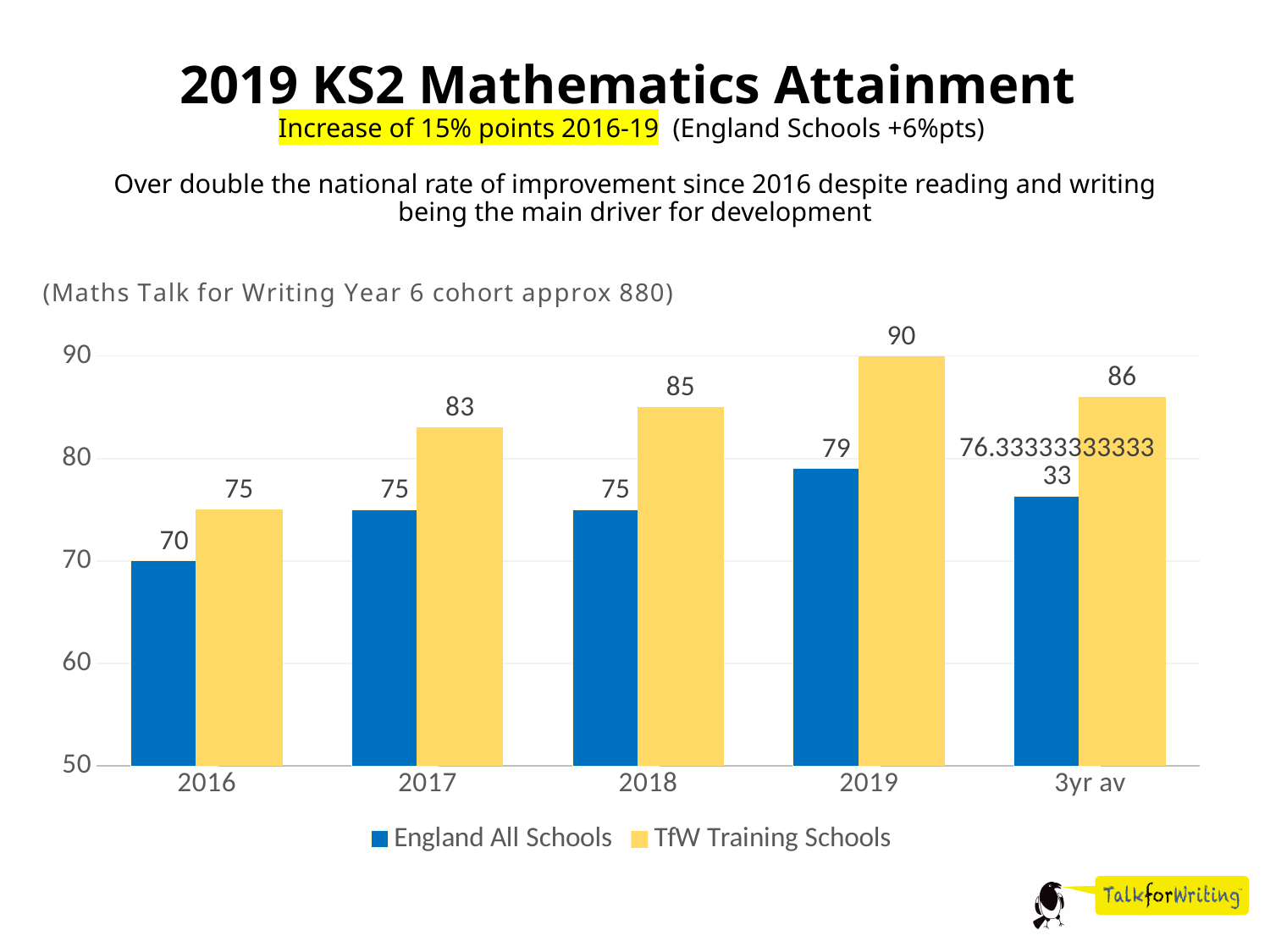
What is the value for TfW Training Schools in 2017? 83 How many series does the legend list? 2 What is the value for England All Schools in 2016? 70 What is the difference between TfW Training Schools and England All Schools in 2018? 10 What is the value for TfW Training Schools in 2019? 90 Is the value for TfW Training Schools in the 3yr av category greater or less than 80? greater In which year does TfW Training Schools reach its highest value? 2019 In which category is the England All Schools value lowest? 2016 Which is larger in 2017: England All Schools or TfW Training Schools? TfW Training Schools What kind of chart is shown on the slide? Bar chart What is the value for England All Schools in 2019? 79 How many categories are shown on the x axis? 5